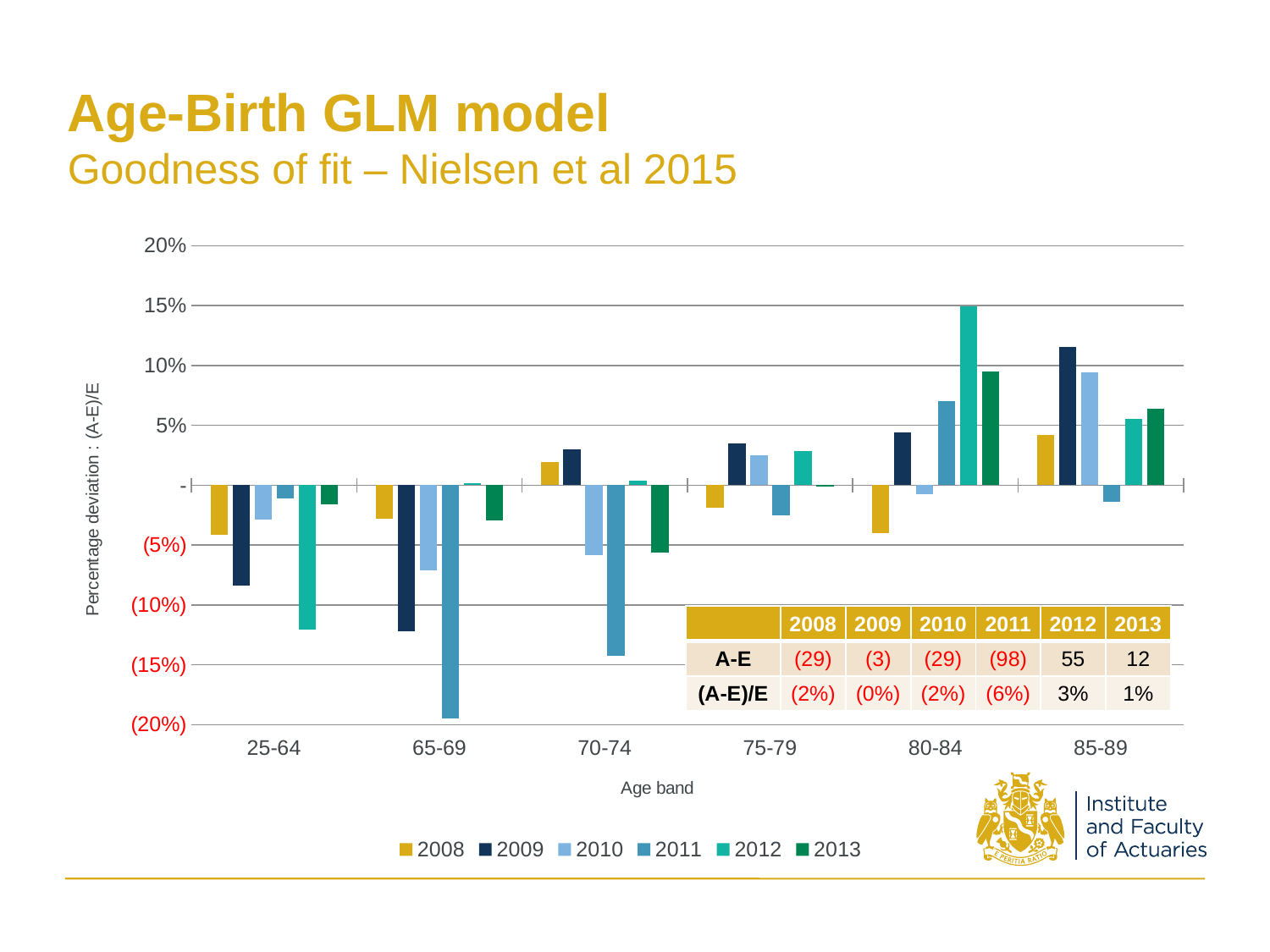
How many age bands are shown on the x axis? 6 Which age band and series has the highest bar in the chart? 2012 in 80-84 How many series does the legend list? 6 Is the value for 2011 in the 70-74 age band greater or less than (10%)? less What is the label of the y axis? Percentage deviation : (A-E)/E Is the value for 2009 in the 25-64 age band greater or less than (5%)? less Which is larger, the value for 2011 in the 65-69 age band or the value for 2011 in the 70-74 age band? 2011 in 70-74 What kind of chart is shown on the slide? bar chart In the 80-84 age band, which series has the highest bar? 2012 Is the value for 2012 in the 80-84 age band greater or less than 10%? greater Which age band and series has the lowest bar in the chart? 2011 in 65-69